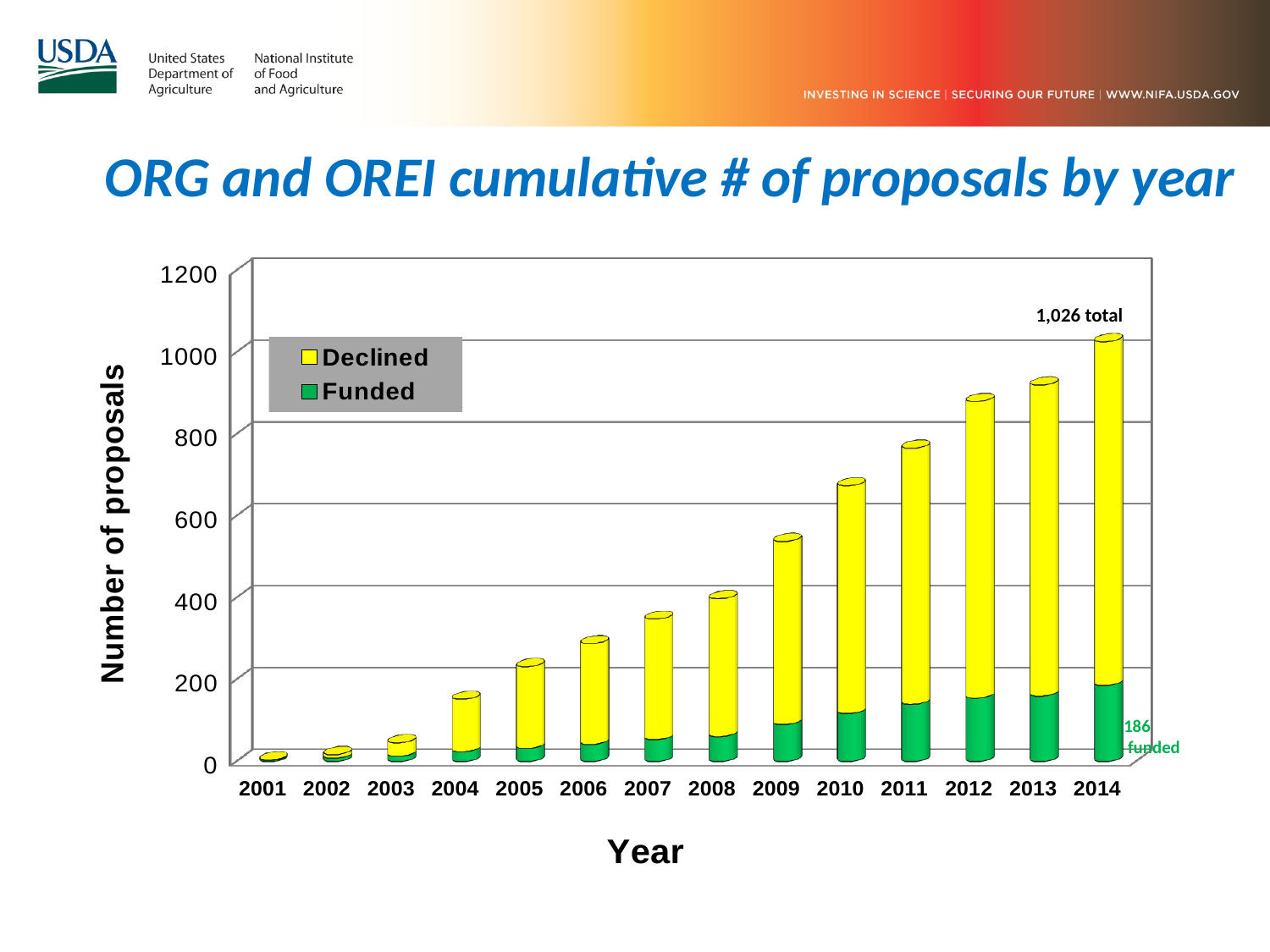
Is the total number of proposals for 2010 greater or less than 600? greater How many years are shown on the x axis? 14 How many proposals are labelled as funded in 2014? 186 Which year has the highest cumulative number of proposals? 2014 Do the cumulative proposal totals rise or fall from 2001 to 2014? rise What is the total number of proposals labelled for 2014? 1,026 total How many series does the legend list? 2 Which year has the lowest cumulative number of proposals? 2001 Which colour represents the Funded series in the legend? green What kind of chart is shown on the slide? bar chart Using the labels for 2014, how many proposals were declined (total minus funded)? 840 Is the total number of proposals for 2011 greater or less than 800? less